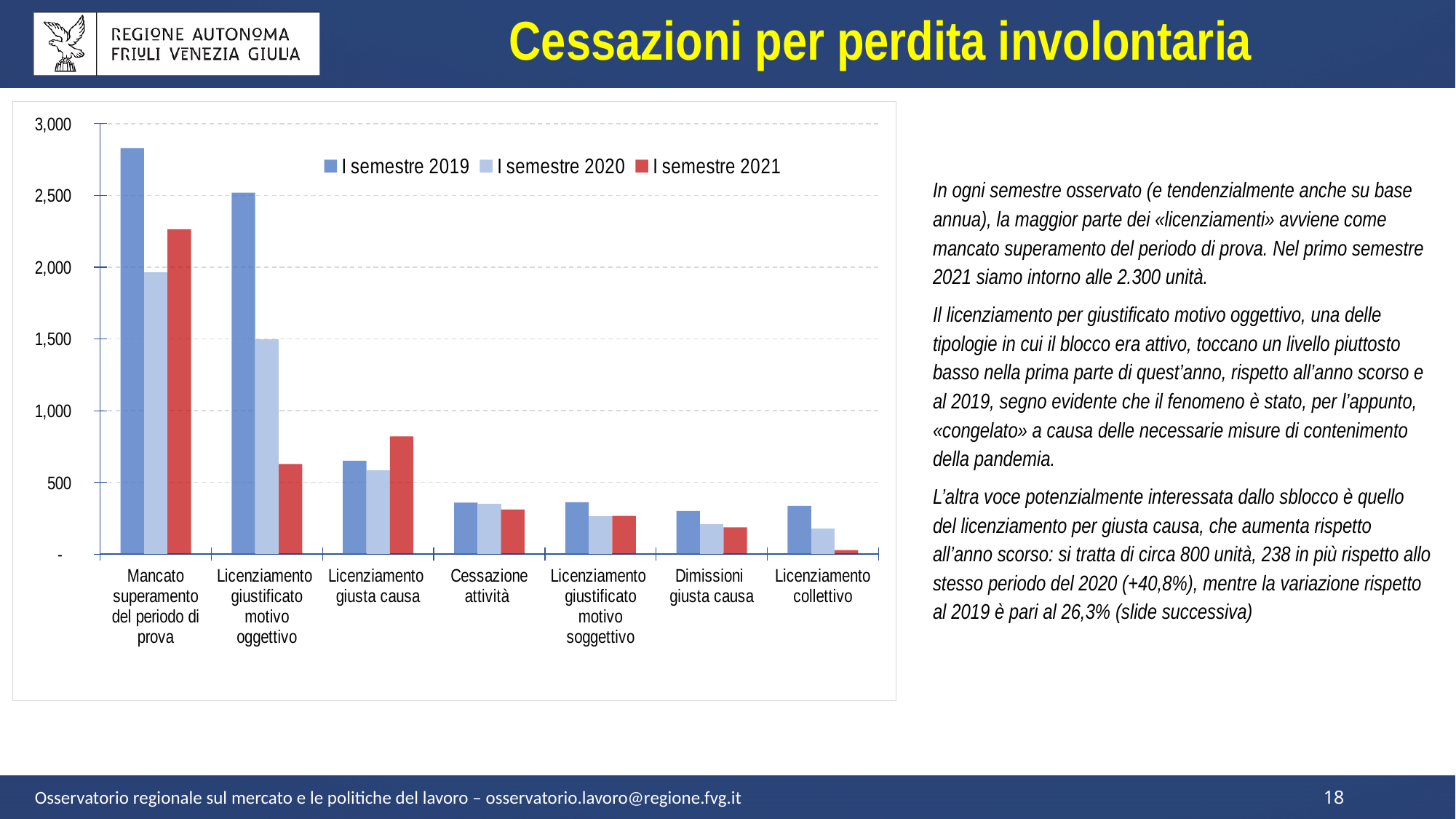
What is the title of the slide containing the chart? Cessazioni per perdita involontaria Which category has the lowest value for I semestre 2021? Licenziamento collettivo For Mancato superamento del periodo di prova, which is larger: the I semestre 2020 value or the I semestre 2021 value? I semestre 2021 Is the I semestre 2021 value for Licenziamento giustificato motivo oggettivo greater or less than 1,000? less How many categories are shown on the x axis of the chart? 7 For Licenziamento giusta causa, which is larger: the I semestre 2019 value or the I semestre 2021 value? I semestre 2021 What type of chart is shown on the slide? Bar chart Is the I semestre 2020 value for Licenziamento giustificato motivo oggettivo greater or less than 1,000? greater How many series does the legend list? 3 Which category has the highest value for I semestre 2019? Mancato superamento del periodo di prova For Licenziamento giustificato motivo oggettivo, do the values rise or fall from I semestre 2019 to I semestre 2021? fall Is the I semestre 2019 value for Mancato superamento del periodo di prova greater or less than 2,500? greater